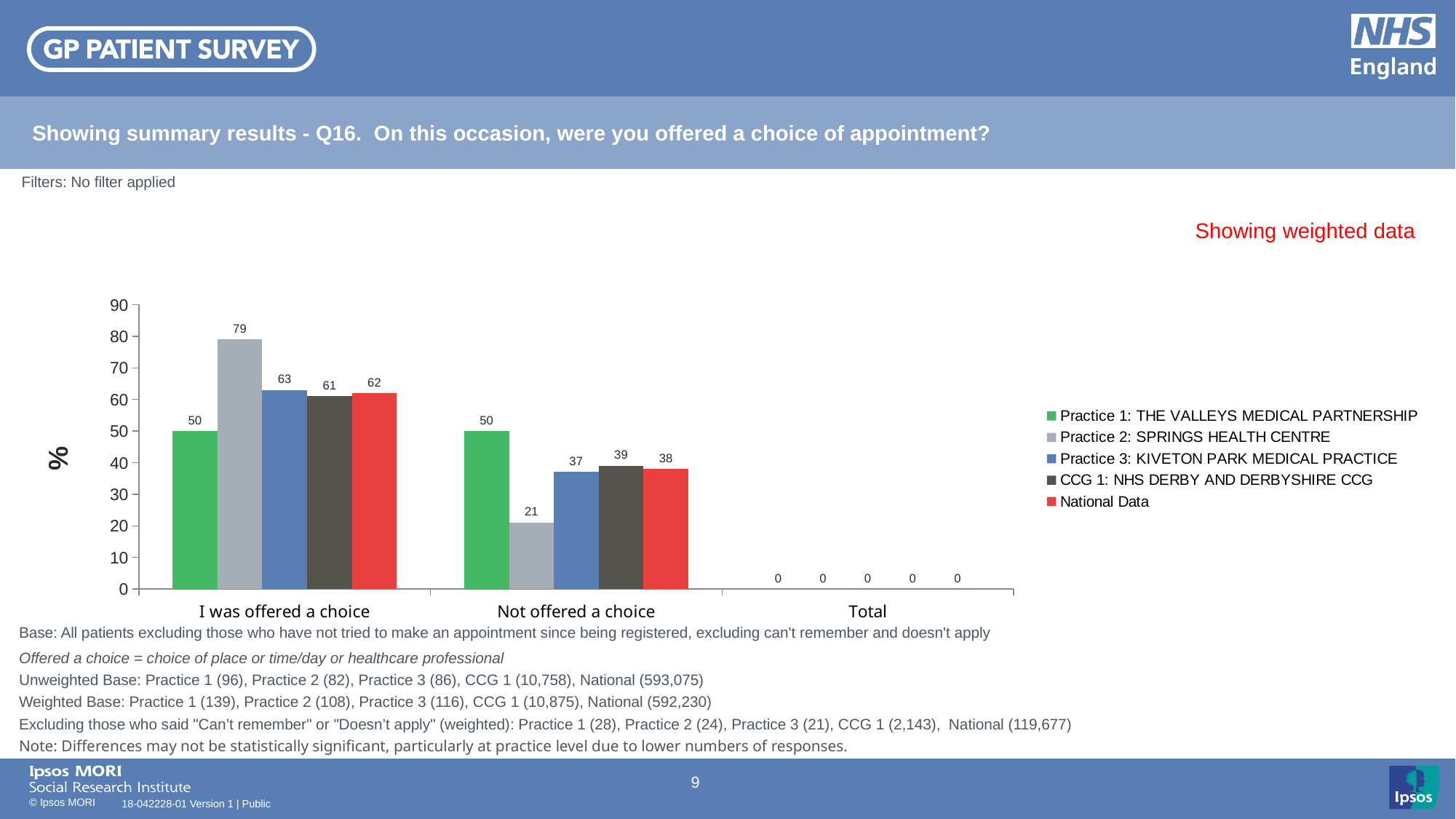
Which series has the lowest value in the 'Not offered a choice' category? Practice 2: SPRINGS HEALTH CENTRE What label is shown on the y axis? % What is the difference between Practice 2 and Practice 1 in the 'I was offered a choice' category? 29 How many categories are shown on the x axis? 3 Which series has the highest value in the 'I was offered a choice' category? Practice 2: SPRINGS HEALTH CENTRE What is the value for Practice 3: KIVETON PARK MEDICAL PRACTICE in the 'Total' category? 0 How many series does the legend list? 5 Which is larger in the 'Not offered a choice' category: Practice 1: THE VALLEYS MEDICAL PARTNERSHIP or Practice 3: KIVETON PARK MEDICAL PRACTICE? Practice 1: THE VALLEYS MEDICAL PARTNERSHIP What is the value for National Data in the 'Not offered a choice' category? 38 What is the value for Practice 2: SPRINGS HEALTH CENTRE in the 'I was offered a choice' category? 79 What is the value for CCG 1: NHS DERBY AND DERBYSHIRE CCG in the 'I was offered a choice' category? 61 What kind of chart is shown on the slide? bar chart